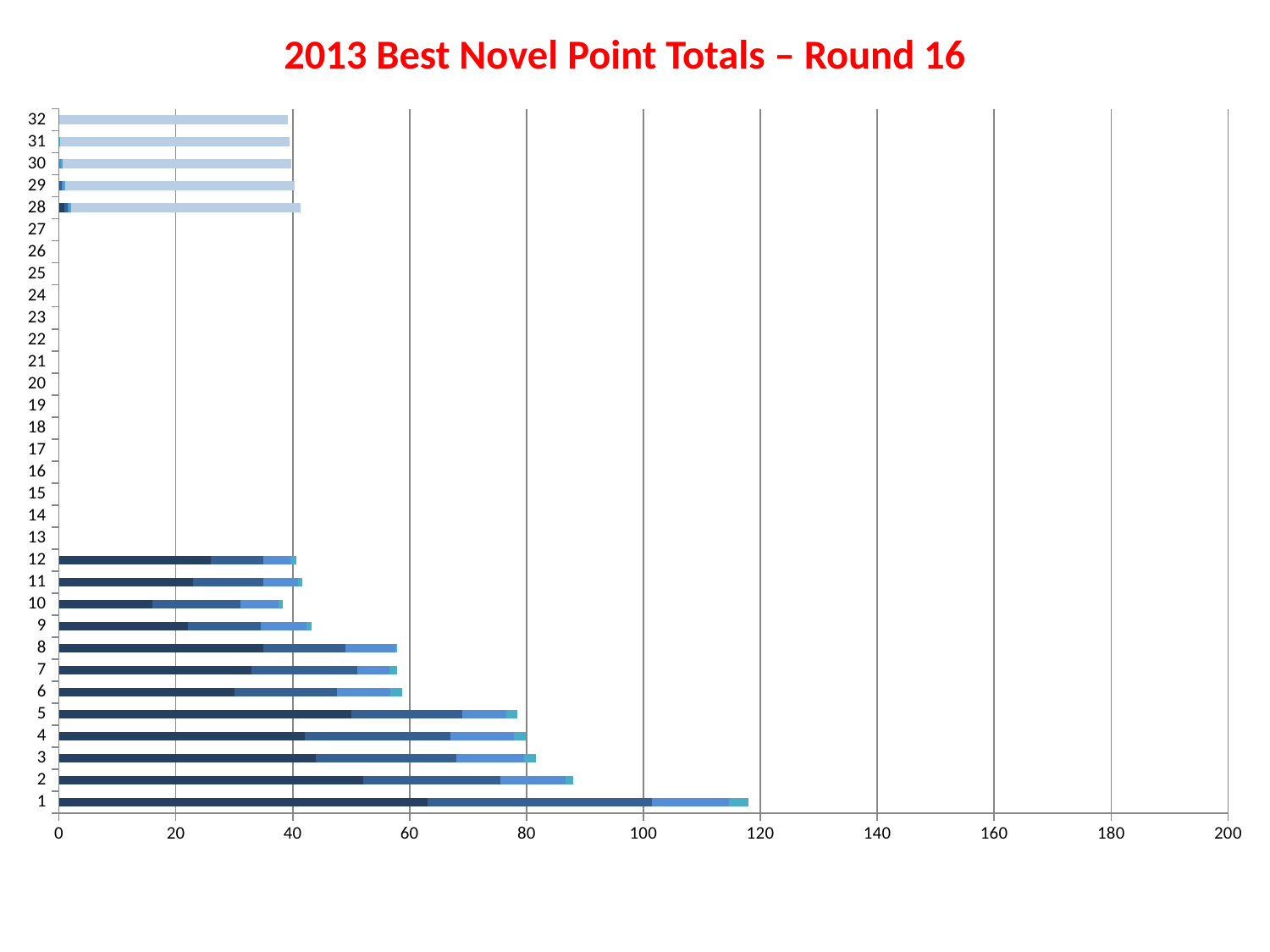
Is the total value for category 1 greater or less than 100? greater Is the total value for category 8 greater or less than 60? less Which has the larger total, category 8 or category 12? 8 Is the total value for category 5 greater or less than 80? less What is the highest value shown on the horizontal axis? 200 What is the title of the chart? 2013 Best Novel Point Totals – Round 16 Which has the larger total, category 1 or category 2? 1 What kind of chart is shown on the slide? bar chart How many categories are listed on the vertical axis of the chart? 32 Which category has the longest bar in the chart? 1